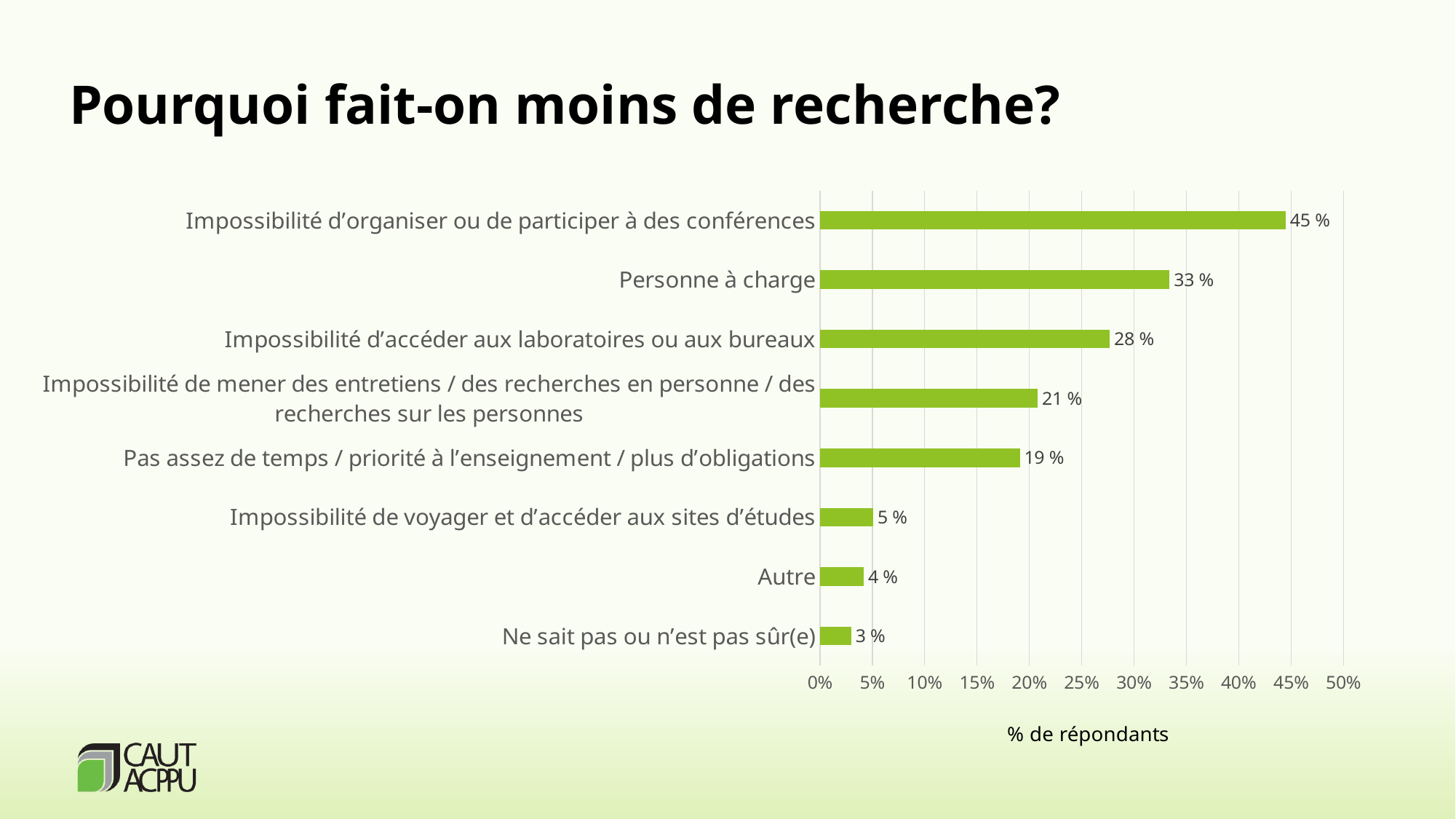
Is the value for "Impossibilité de mener des entretiens / des recherches en personne / des recherches sur les personnes" greater or less than 25%? less What kind of chart is shown on the slide? bar chart What is the difference between the values for "Impossibilité d'organiser ou de participer à des conférences" and "Personne à charge"? 12 % Which is larger: the value for "Pas assez de temps / priorité à l'enseignement / plus d'obligations" or the value for "Impossibilité de voyager et d'accéder aux sites d'études"? Pas assez de temps / priorité à l'enseignement / plus d'obligations What is the title of the slide? Pourquoi fait-on moins de recherche? What is the value for "Impossibilité d'accéder aux laboratoires ou aux bureaux"? 28 % Which category has the highest value? Impossibilité d'organiser ou de participer à des conférences Which category has the lowest value? Ne sait pas ou n'est pas sûr(e) What is the value for "Personne à charge"? 33 % What is the label of the horizontal axis? % de répondants How many categories are shown in the chart? 8 What is the value for "Autre"? 4 %